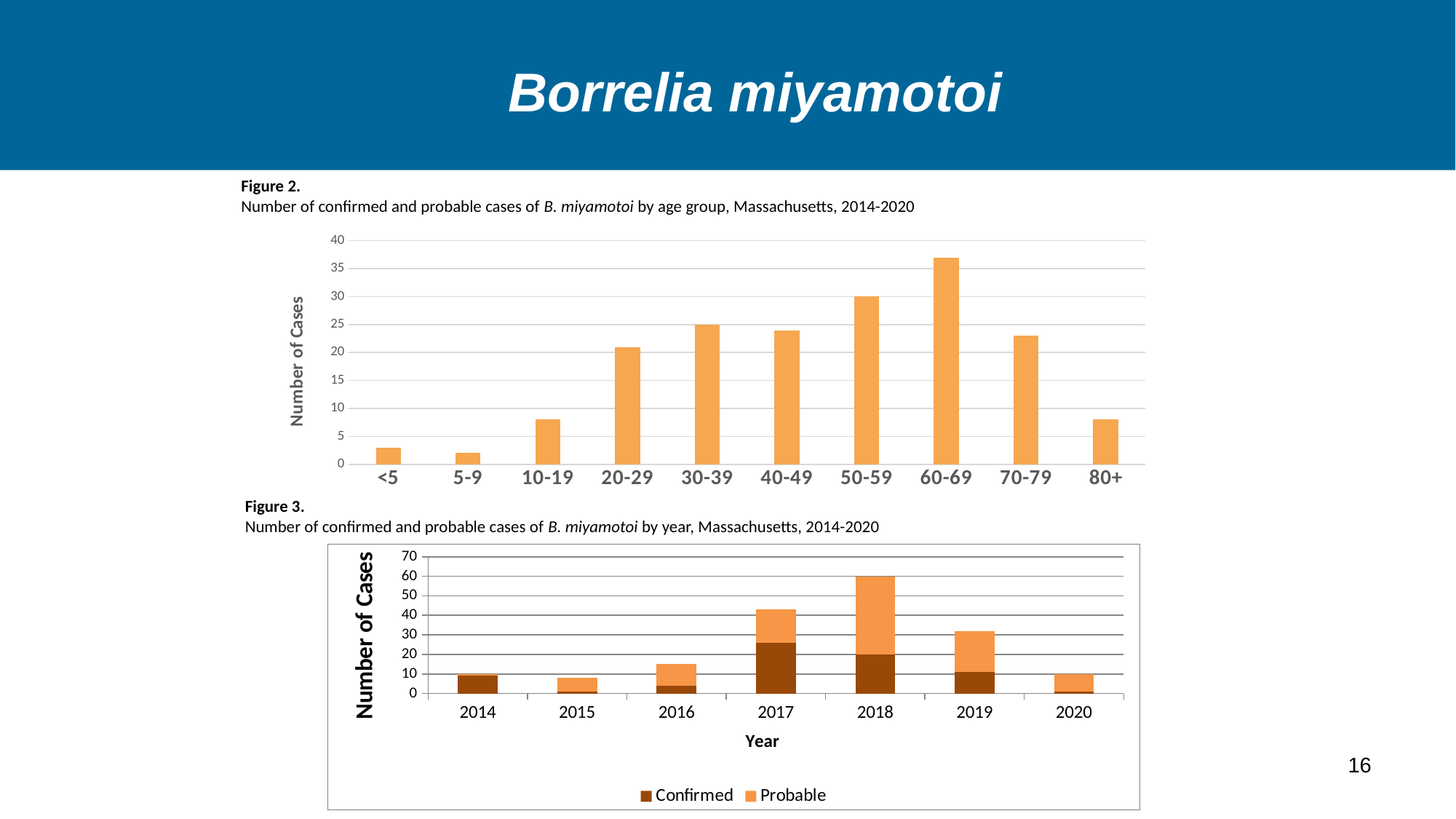
In Figure 2 (cases by age group), which age group has the highest number of cases? 60-69 In Figure 2 (cases by age group), how many age groups are shown on the x axis? 10 In Figure 2 (cases by age group), is the value for the 60-69 age group greater or less than 35? greater In Figure 3 (cases by year), how many years are shown on the x axis? 7 In Figure 2 (cases by age group), is the value for the 80+ age group greater or less than 10? less In Figure 2 (cases by age group), which age group has the lowest number of cases? 5-9 In Figure 3 (cases by year), is the total number of cases in 2017 greater or less than 40? greater In Figure 3 (cases by year), what are the two series named in the legend? Confirmed and Probable In Figure 2 (cases by age group), what kind of chart is shown? bar chart In Figure 3 (cases by year), which year has the highest total number of cases? 2018 In Figure 2 (cases by age group), which has more cases, the 50-59 age group or the 40-49 age group? 50-59 In Figure 3 (cases by year), how many series does the legend list? 2